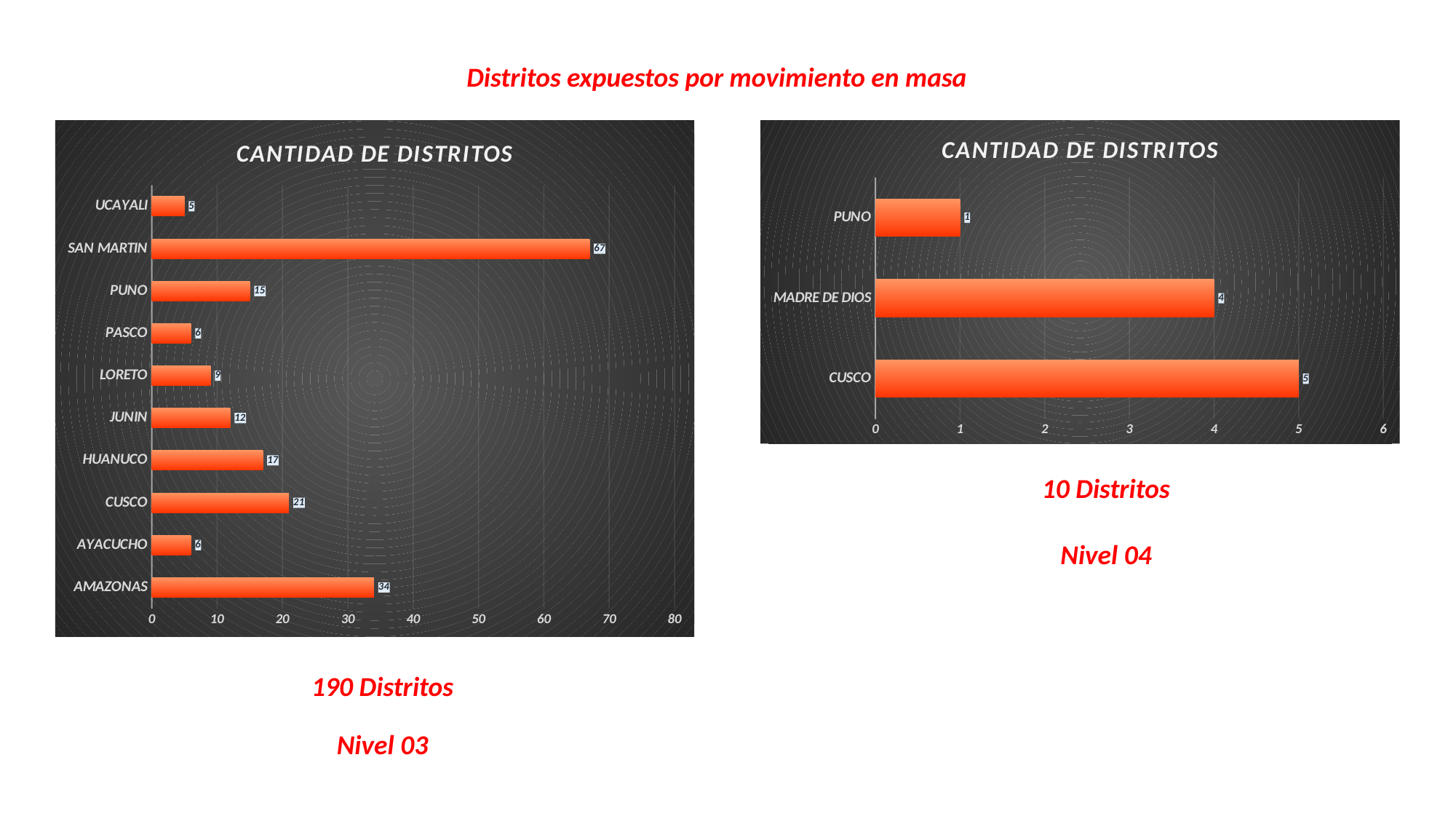
In the right chart (Nivel 04), what is the value for MADRE DE DIOS? 4 In the left chart (Nivel 03), what is the value for JUNIN? 12 In the left chart (Nivel 03), which category has the highest value? SAN MARTIN In the left chart (Nivel 03), how many categories are shown? 10 In the left chart (Nivel 03), what is the value for AMAZONAS? 34 In the left chart (Nivel 03), what is the value for SAN MARTIN? 67 In the left chart (Nivel 03), which category has the lowest value? UCAYALI In the left chart (Nivel 03), what is the difference between the values for SAN MARTIN and AMAZONAS? 33 In the right chart (Nivel 04), how many categories are shown? 3 In the left chart (Nivel 03), which is larger, the value for CUSCO or the value for HUANUCO? CUSCO What kind of chart is the right chart (Nivel 04)? Bar chart In the right chart (Nivel 04), which category has the highest value? CUSCO